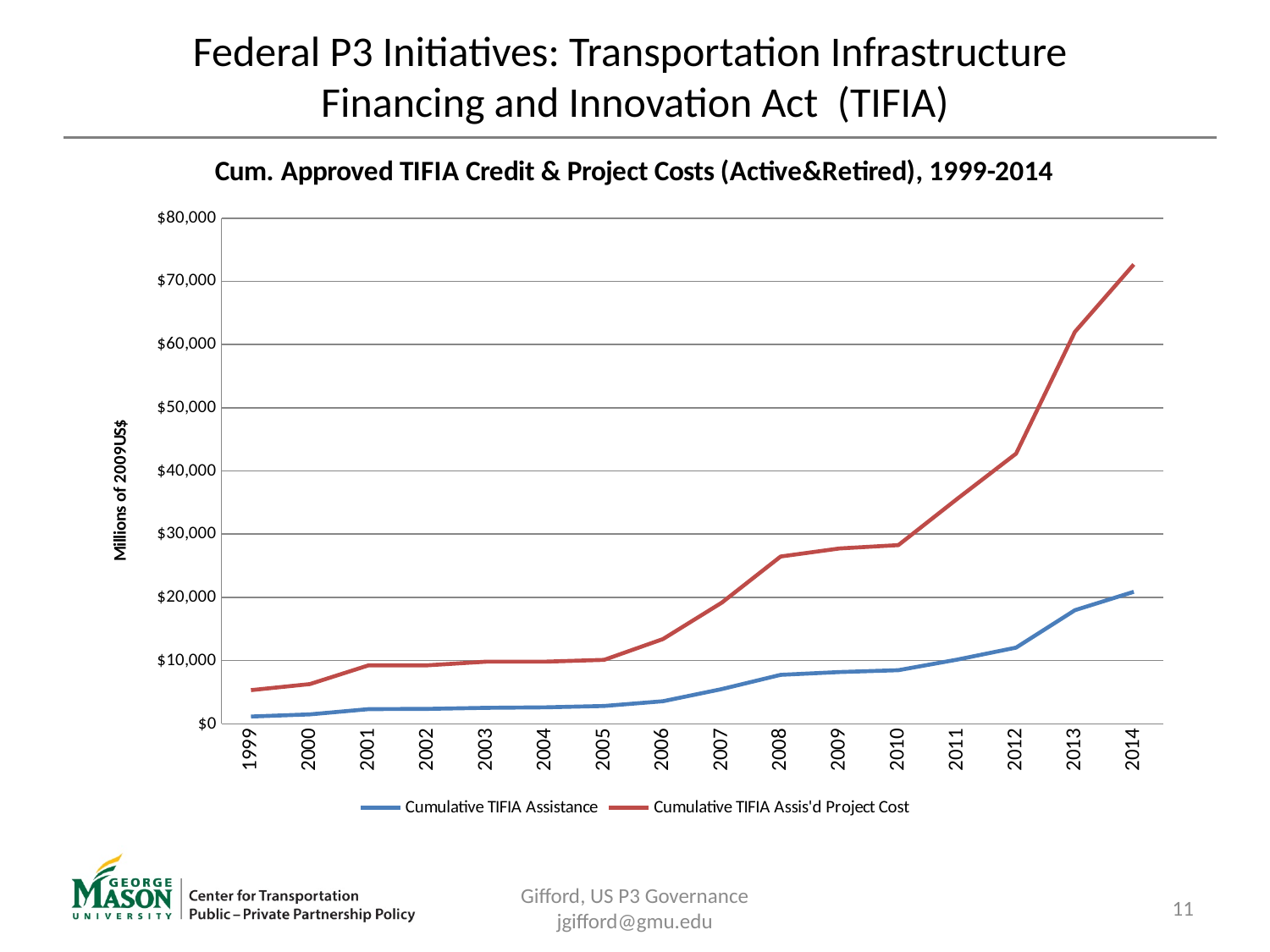
What is the label on the vertical axis of the chart? Millions of 2009US$ Does the Cumulative TIFIA Assis'd Project Cost series rise or fall from 1999 to 2014? rise In which year does the Cumulative TIFIA Assis'd Project Cost series reach its highest value? 2014 What kind of chart is shown on the slide? line chart In 2014, which series has the larger value: Cumulative TIFIA Assistance or Cumulative TIFIA Assis'd Project Cost? Cumulative TIFIA Assis'd Project Cost Is the Cumulative TIFIA Assistance value for 2013 greater or less than $20,000? less Is the Cumulative TIFIA Assis'd Project Cost value for 2012 greater or less than $40,000? greater Is the Cumulative TIFIA Assistance value for 2008 greater or less than $10,000? less How many series does the legend list? 2 How many years are plotted along the x axis? 16 In which year is the Cumulative TIFIA Assistance series at its lowest value? 1999